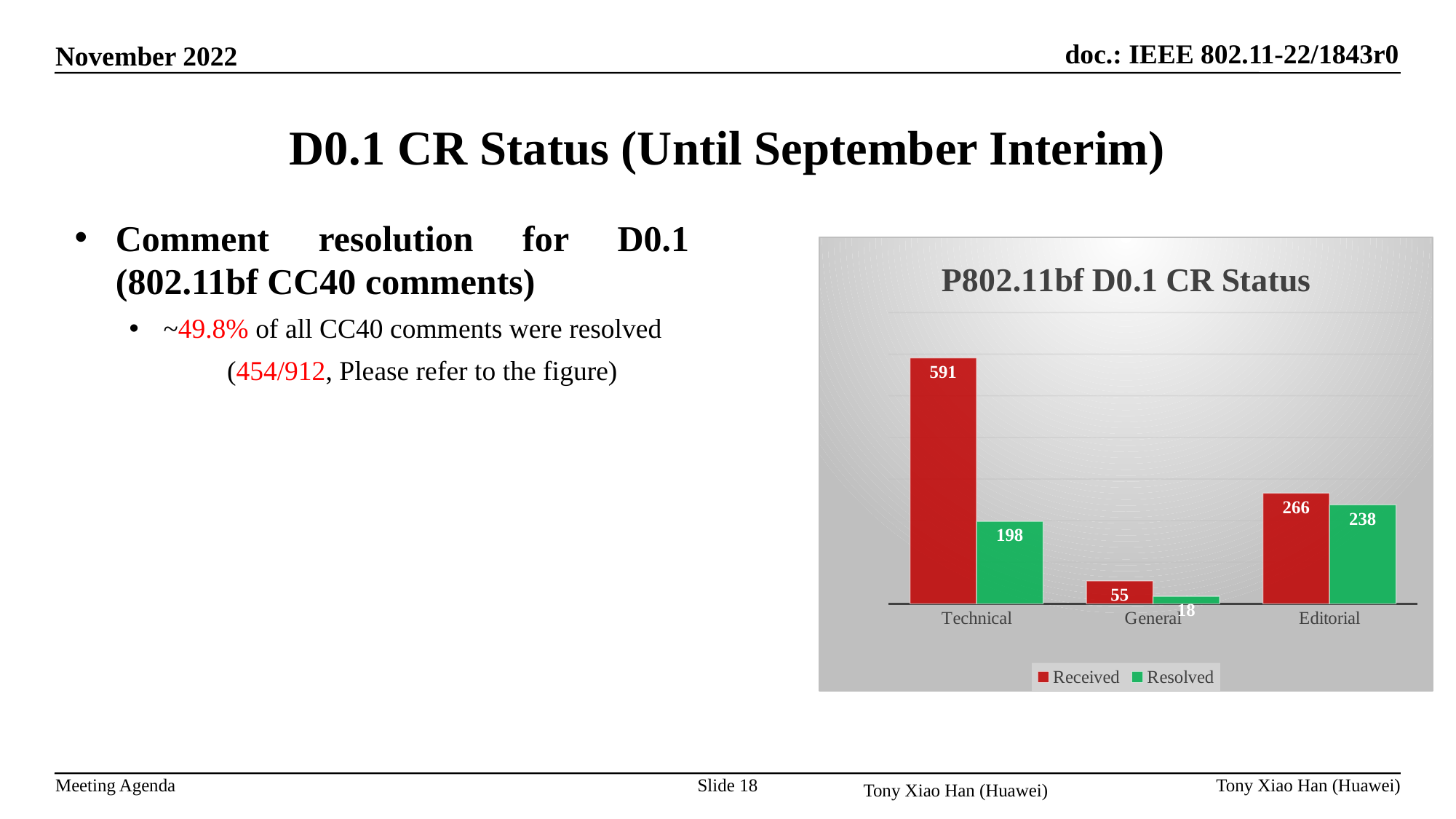
What is the difference between Received and Resolved for Editorial? 28 What is the Received value for Technical? 591 What is the Resolved value for Editorial? 238 Which is larger for General: Received or Resolved? Received Which category has the lowest Resolved value? General What is the Resolved value for General? 18 How many series does the legend list? 2 Which category has the highest Received value? Technical What is the difference between Received and Resolved for Technical? 393 What is the title of the chart? P802.11bf D0.1 CR Status How many categories are shown on the x axis? 3 What kind of chart is shown? Bar chart